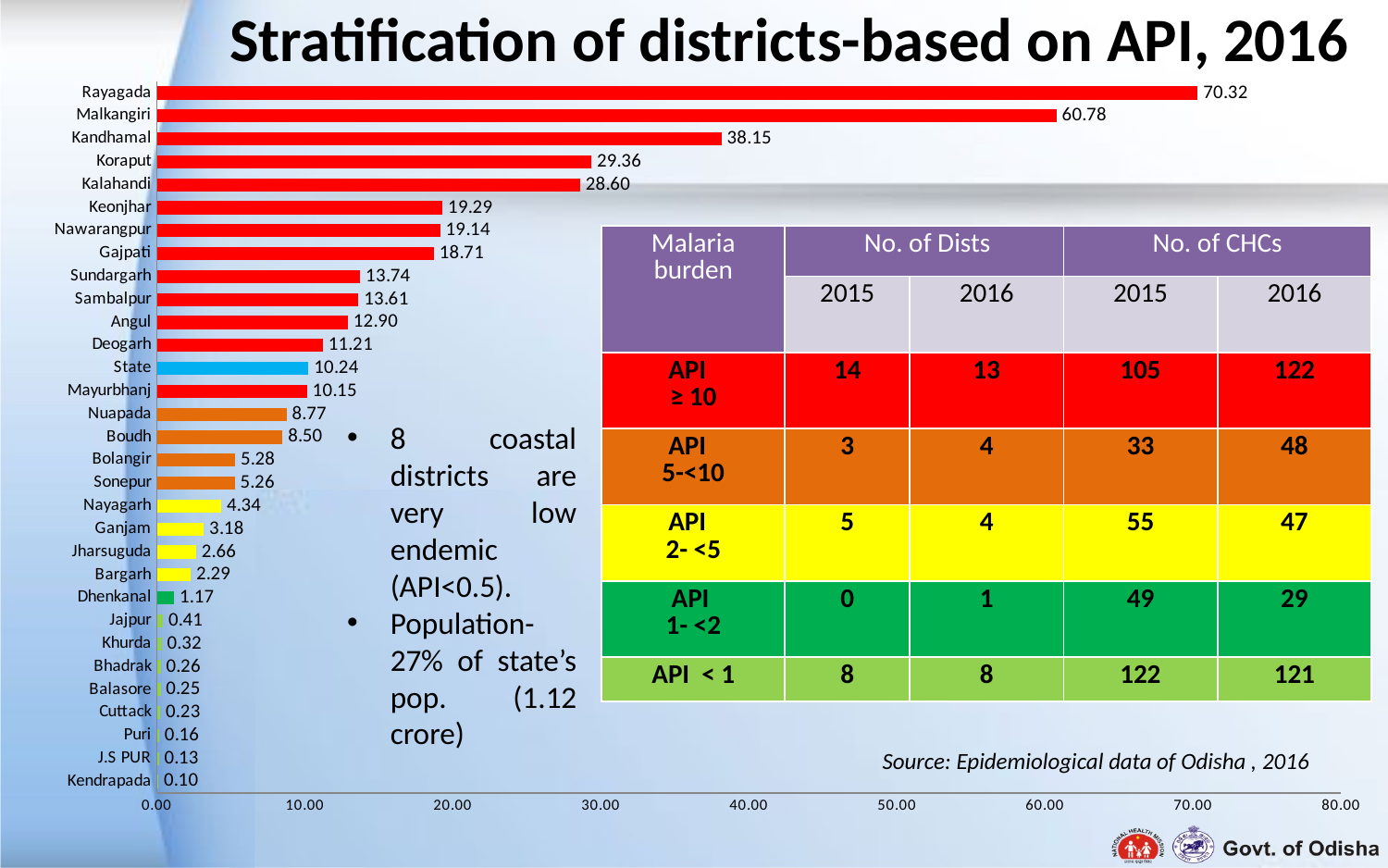
Which district has the lowest API value in the chart? Kendrapada Which has a higher API value, Koraput or Kalahandi? Koraput What is the API value shown for Kandhamal? 38.15 What is the API value shown for Rayagada? 70.32 What is the title of the slide containing the chart? Stratification of districts-based on API, 2016 What type of chart is shown on the slide? Bar chart How many bars (categories) are plotted in the chart? 31 What is the value shown for the State bar? 10.24 Is the value for Malkangiri greater or less than 50.00? greater What is the API value shown for Kendrapada? 0.10 Which district has the highest API value in the chart? Rayagada What is the difference between the API values of Rayagada and Malkangiri? 9.54